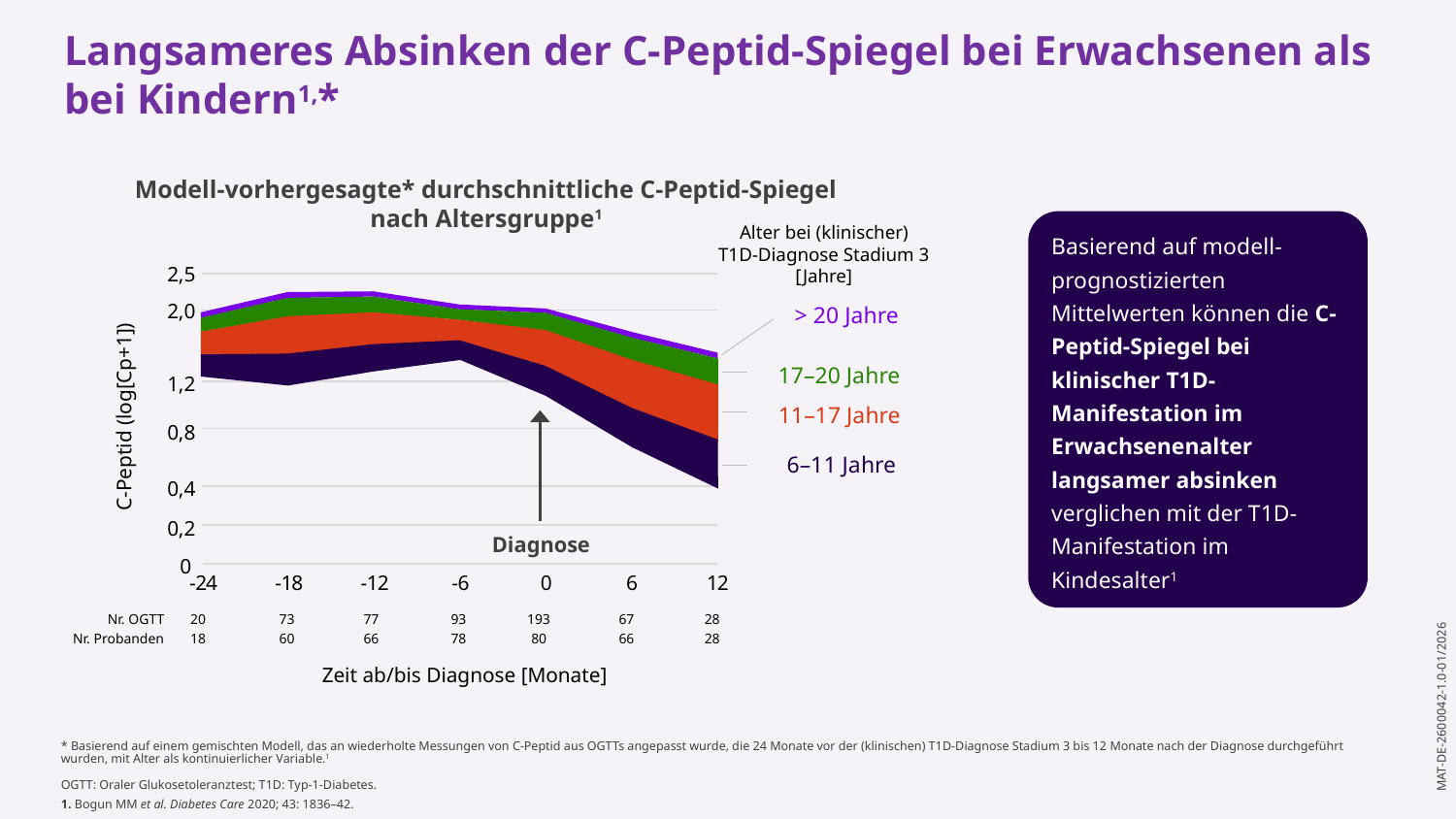
Is the value for the > 20 Jahre group at 12 months greater or less than 1.2? greater What is the number of OGTTs (Nr. OGTT) at month 0 in the table below the chart? 193 What kind of chart is shown on the slide? Area chart How many time points are shown on the x axis of the chart? 7 What event does the vertical arrow at month 0 mark on the chart? Diagnose Is the value for the 6–11 Jahre group at 12 months greater or less than 0.8? less Do the C-peptide values for the 6–11 Jahre group rise or fall between month 0 and month 12? fall How many age groups does the legend of the chart list? 4 Which age group is shown in purple at the top of the chart? > 20 Jahre At 12 months after diagnosis, which group has the higher C-peptide value: > 20 Jahre or 6–11 Jahre? > 20 Jahre At which time point is the number of OGTTs (Nr. OGTT) highest? 0 What is the difference between the number of OGTTs at month 0 and at month 6? 126